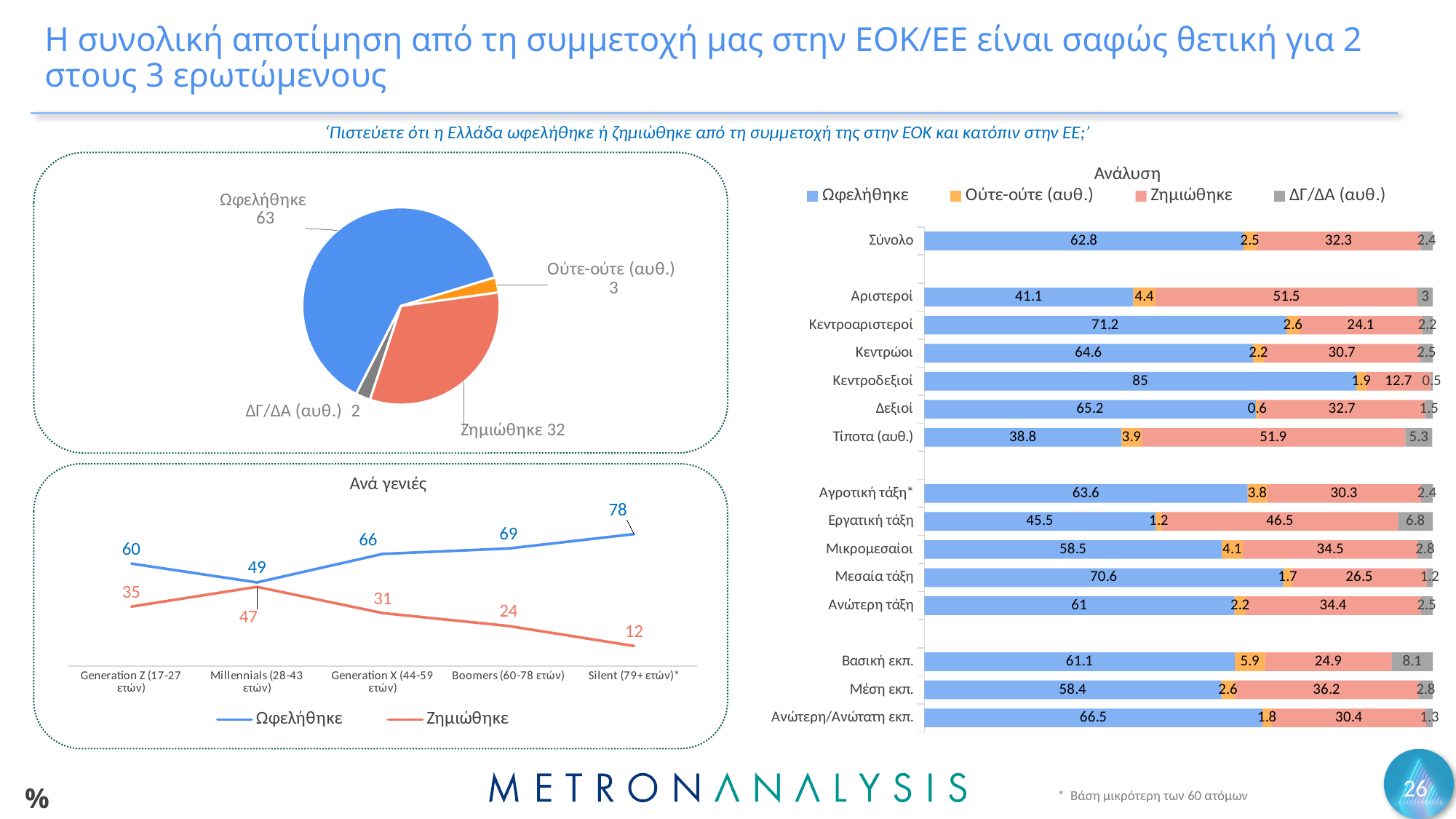
In the 'Ανά γενιές' chart, what is the Ωφελήθηκε value for Silent (79+ ετών)*? 78 In the pie chart on the left, what share of the pie does Ούτε-ούτε (αυθ.) represent? 3% How many series does the legend of the 'Ανά γενιές' chart list? 2 In the 'Ανά γενιές' chart, what is the Ζημιώθηκε value for Millennials (28-43 ετών)? 47 In the 'Ανάλυση' chart, what is the total of the stacked bar for Σύνολο? 100 In the 'Ανάλυση' chart, what is the Ωφελήθηκε value for Κεντροδεξιοί? 85 In the 'Ανάλυση' chart, which category has the highest Ωφελήθηκε value? Κεντροδεξιοί In the pie chart on the left, what is the value for Ζημιώθηκε? 32 In the 'Ανάλυση' chart, which has the larger ΔΓ/ΔΑ (αυθ.) value, Βασική εκπ. or Μέση εκπ.? Βασική εκπ. In the pie chart on the left, which category has the largest slice? Ωφελήθηκε In the 'Ανά γενιές' chart, what is the difference between Ωφελήθηκε and Ζημιώθηκε for Boomers (60-78 ετών)? 45 What kind of chart is the 'Ανά γενιές' chart? Line chart